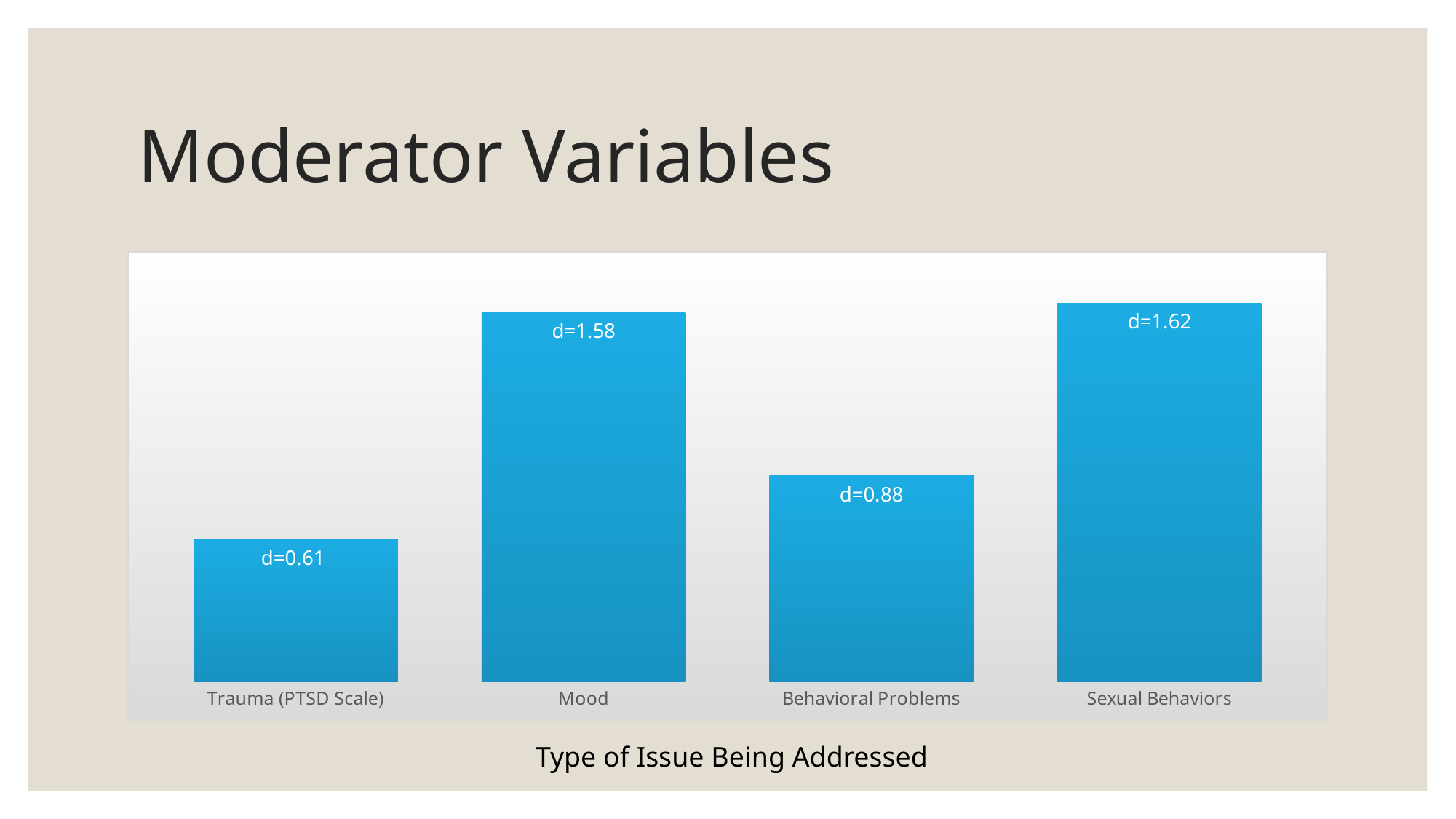
What kind of chart is shown on the slide? Bar chart What is the value shown for Sexual Behaviors? d=1.62 Which category has the lowest value? Trauma (PTSD Scale) What is the difference between the values for Mood and Behavioral Problems? 0.70 What is the label shown beneath the chart's x axis? Type of Issue Being Addressed What is the value shown for Mood? d=1.58 Which category has the highest value? Sexual Behaviors How many categories are shown in the chart? 4 What is the value shown for Behavioral Problems? d=0.88 What is the value shown for Trauma (PTSD Scale)? d=0.61 Which has a larger value, Behavioral Problems or Trauma (PTSD Scale)? Behavioral Problems What is the difference between the values for Sexual Behaviors and Trauma (PTSD Scale)? 1.01